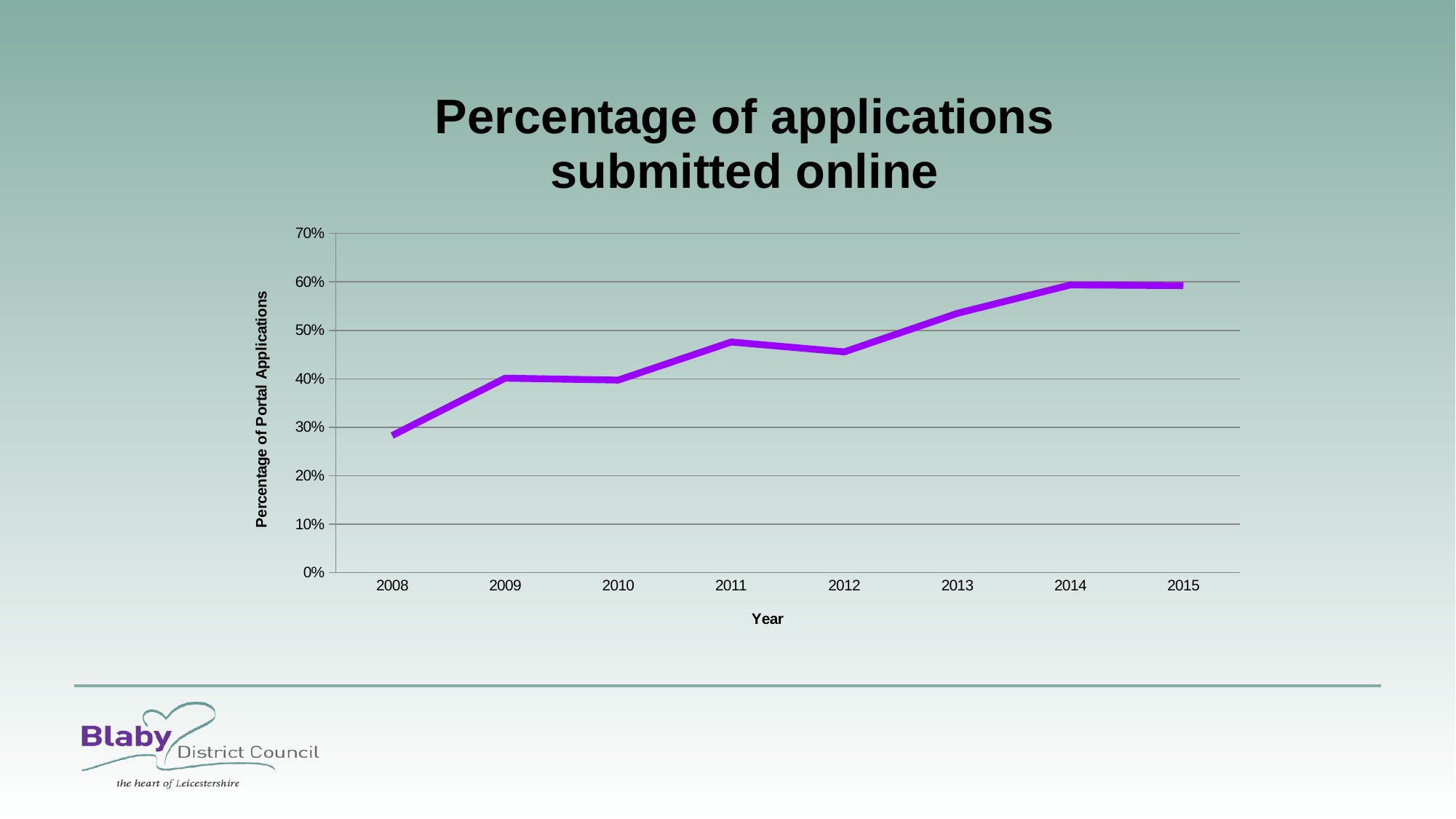
Is the value for 2008 greater or less than 40%? less Is the value for 2013 greater or less than 50%? greater What is the title of the chart? Percentage of applications submitted online What is the label on the y axis? Percentage of Portal Applications Overall, do the values rise or fall from 2008 to 2015? rise Which year has the higher value, 2011 or 2012? 2011 Which year has the lowest percentage of applications submitted online? 2008 How many years are plotted on the x axis? 8 Is the value for 2012 greater or less than 40%? greater What kind of chart is shown on the slide? line chart